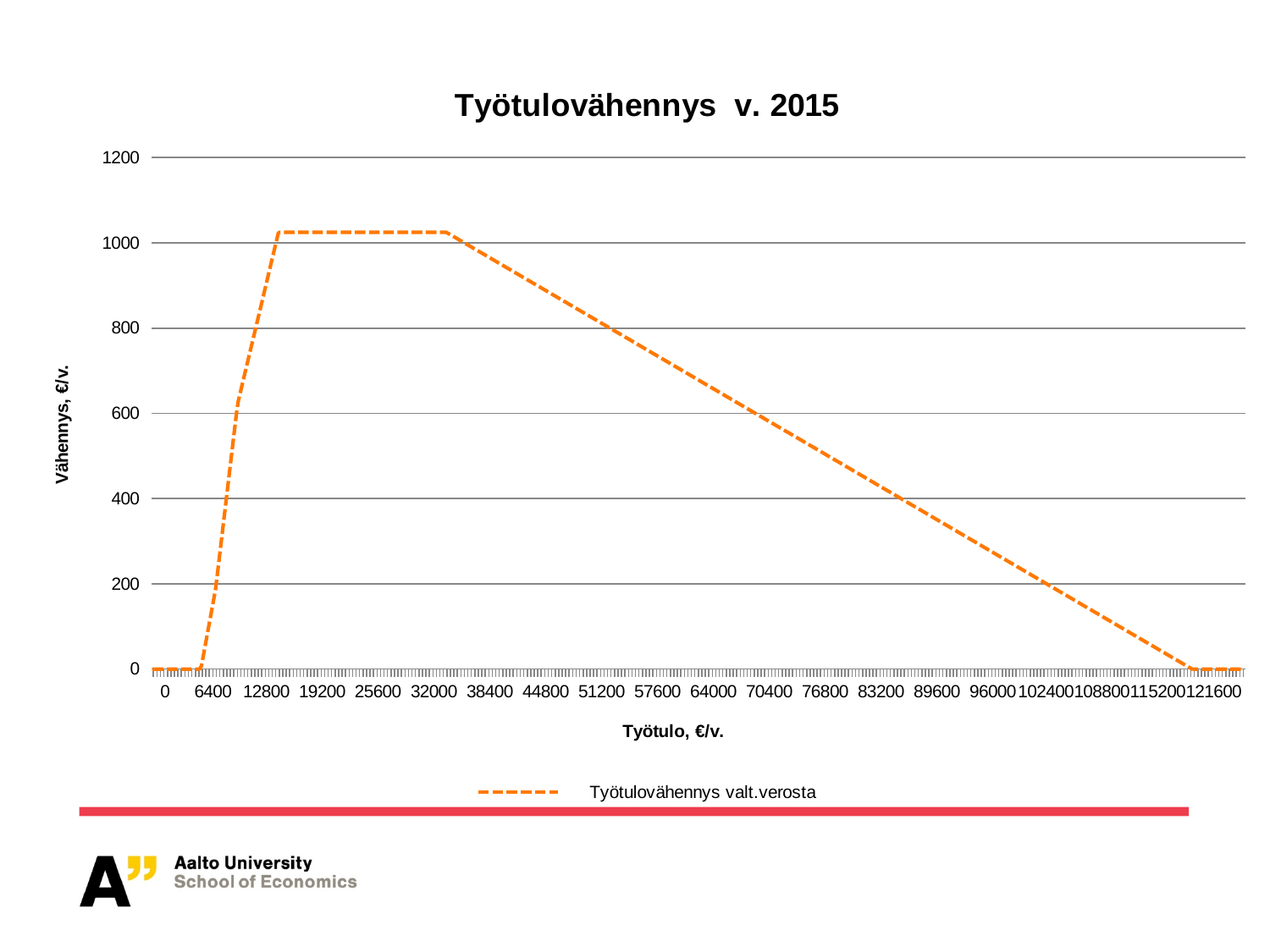
What is the title of the chart? Työtulovähennys v. 2015 Does the value of Työtulovähennys valt.verosta rise or fall as Työtulo increases from 6400 to 12800? rise What kind of chart is shown on the slide? line chart What is the value of Työtulovähennys valt.verosta at a Työtulo of 0? 0 Is the value of Työtulovähennys valt.verosta at a Työtulo of 44800 greater or less than 800? greater Which is larger, the value of Työtulovähennys valt.verosta at a Työtulo of 25600 or at 102400? 25600 Does the value of Työtulovähennys valt.verosta rise or fall as Työtulo increases from 38400 to 115200? fall Is the value of Työtulovähennys valt.verosta at a Työtulo of 6400 greater or less than 400? less Is the value of Työtulovähennys valt.verosta at a Työtulo of 64000 greater or less than 600? greater How many series does the legend list? 1 What is the name of the series shown in the legend? Työtulovähennys valt.verosta